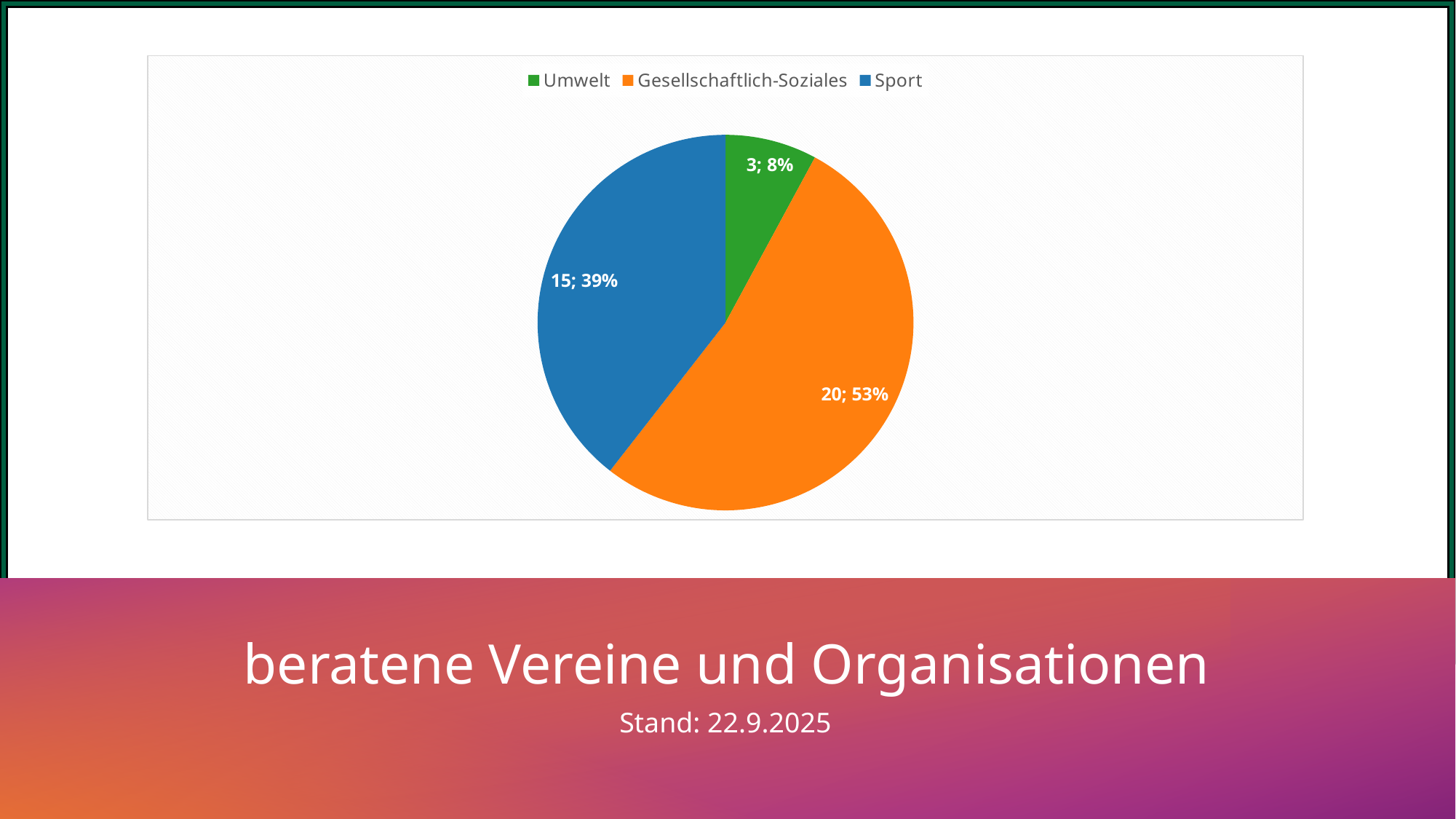
Which colour represents Sport in the pie chart? blue What is the value for Sport? 15 How many entries does the legend list? 3 What share of the pie does Sport represent? 39% What is the difference between the values for Gesellschaftlich-Soziales and Sport? 5 What share of the pie does Umwelt represent? 8% Which category has the smallest slice? Umwelt What is the value for Gesellschaftlich-Soziales? 20 What kind of chart is shown on the slide? pie chart Which category has the largest slice? Gesellschaftlich-Soziales How many slices does the pie chart have? 3 What is the value for Umwelt? 3